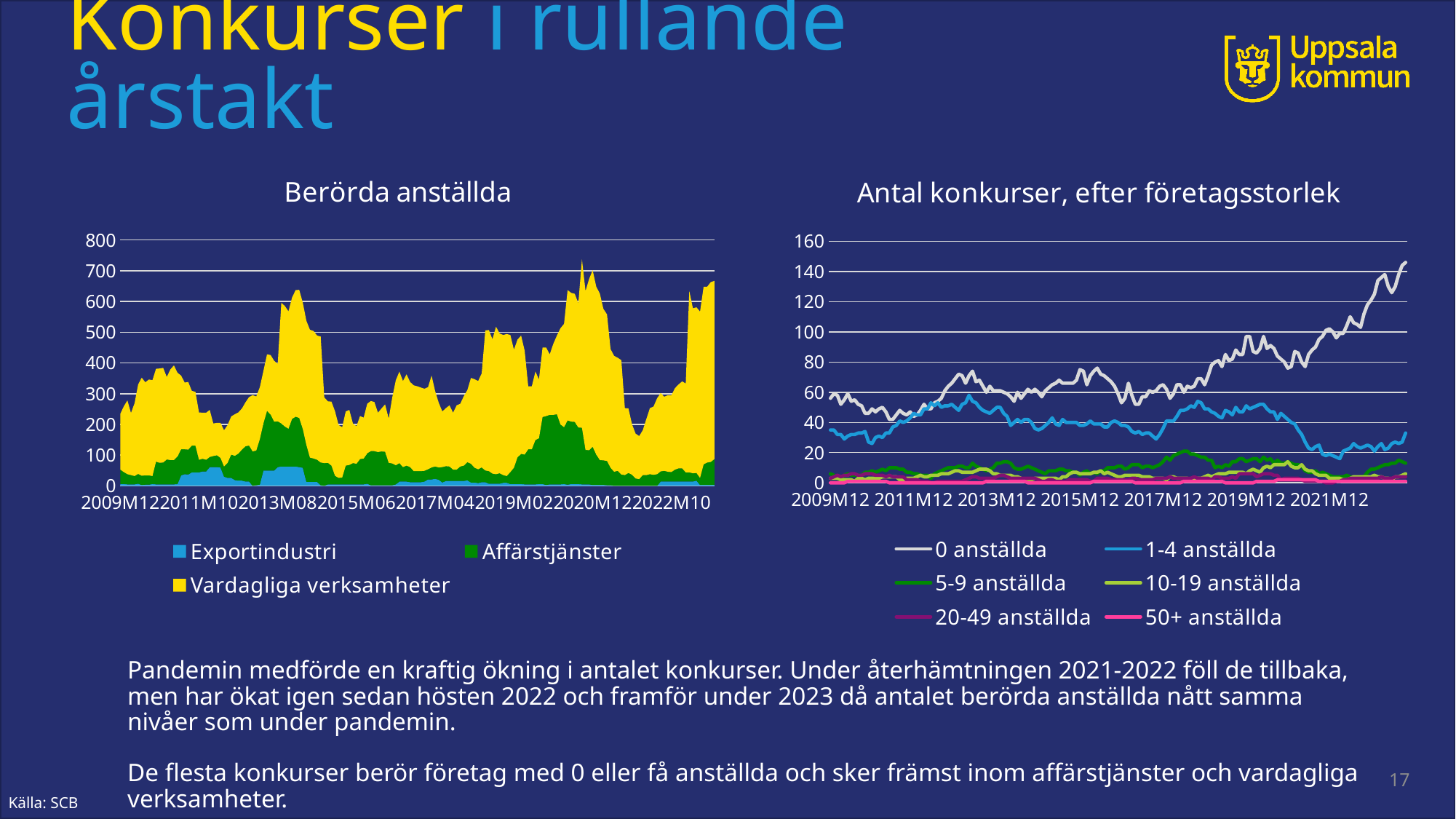
In the left chart "Berörda anställda", which series accounts for the largest share of the stacked area? Vardagliga verksamheter In the right chart "Antal konkurser, efter företagsstorlek", does the "0 anställda" series rise or fall overall from 2009M12 to the end of the period? rise In the right chart "Antal konkurser, efter företagsstorlek", is the value of the "0 anställda" series at 2009M12 greater or less than 80? less In the left chart "Berörda anställda", is the total stacked value at the end of the period greater or less than 600? greater How many series does the legend of the right chart "Antal konkurser, efter företagsstorlek" list? 6 In the right chart "Antal konkurser, efter företagsstorlek", is the final value of the "0 anställda" series greater or less than 120? greater How many series does the legend of the left chart "Berörda anställda" list? 3 In the right chart "Antal konkurser, efter företagsstorlek", which series has the highest value at the end of the period? 0 anställda What kind of chart is the right chart titled "Antal konkurser, efter företagsstorlek"? Line chart In the right chart "Antal konkurser, efter företagsstorlek", which is larger at the end of the period: "0 anställda" or "1-4 anställda"? 0 anställda What kind of chart is the left chart titled "Berörda anställda"? Stacked area chart